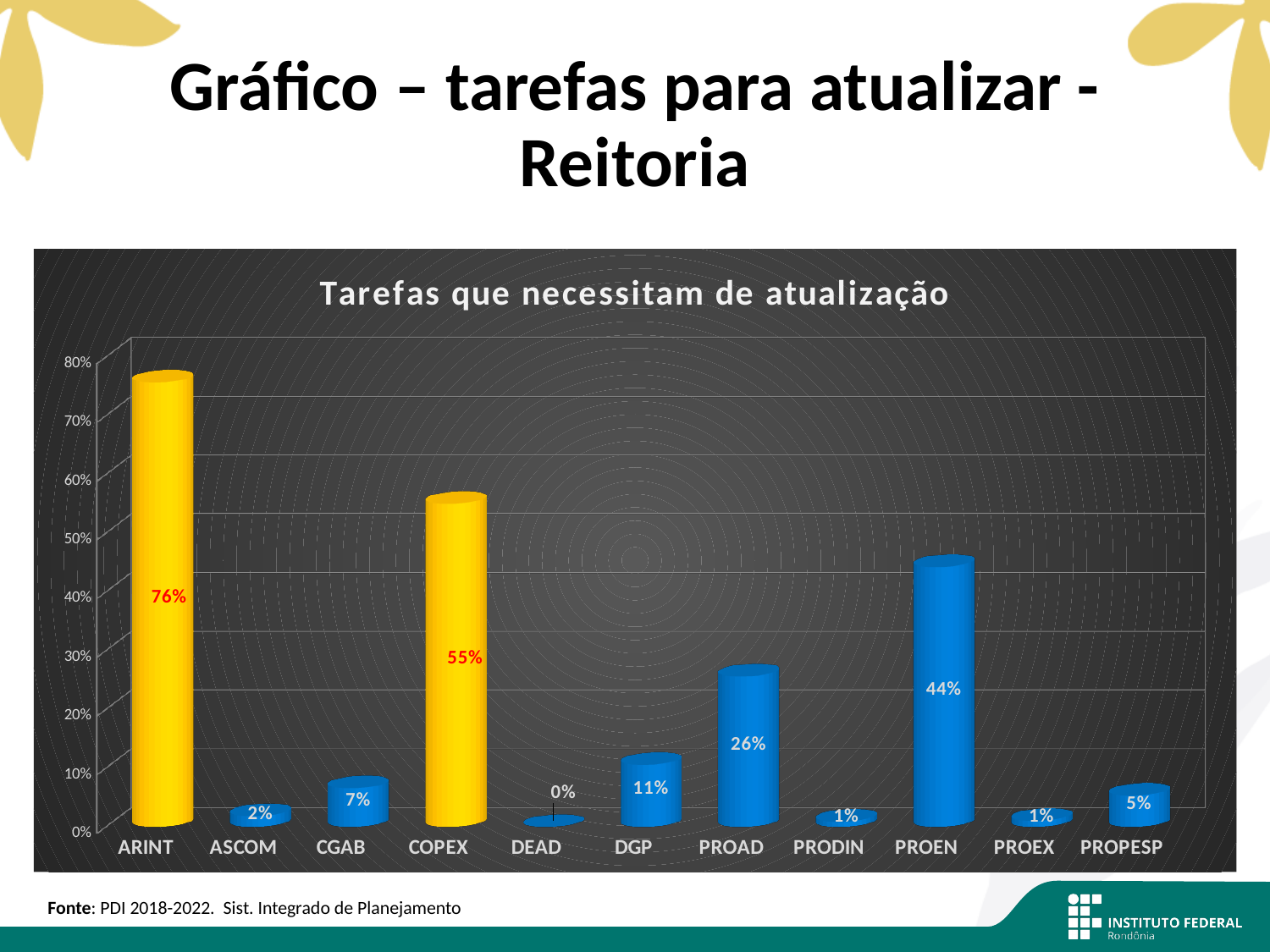
Which category has the highest value? ARINT What is the value for PROEN? 44% What is the value for DEAD? 0% What kind of chart is this? bar chart Which is larger, the value for PROAD or the value for DGP? PROAD Which two categories have yellow bars? ARINT and COPEX What is the difference between the values for ARINT and COPEX? 21% How many categories are shown on the x axis? 11 Which category has the lowest value? DEAD What is the title of the chart? Tarefas que necessitam de atualização What is the value for ARINT? 76% Is the value for PROEN greater or less than 40%? greater